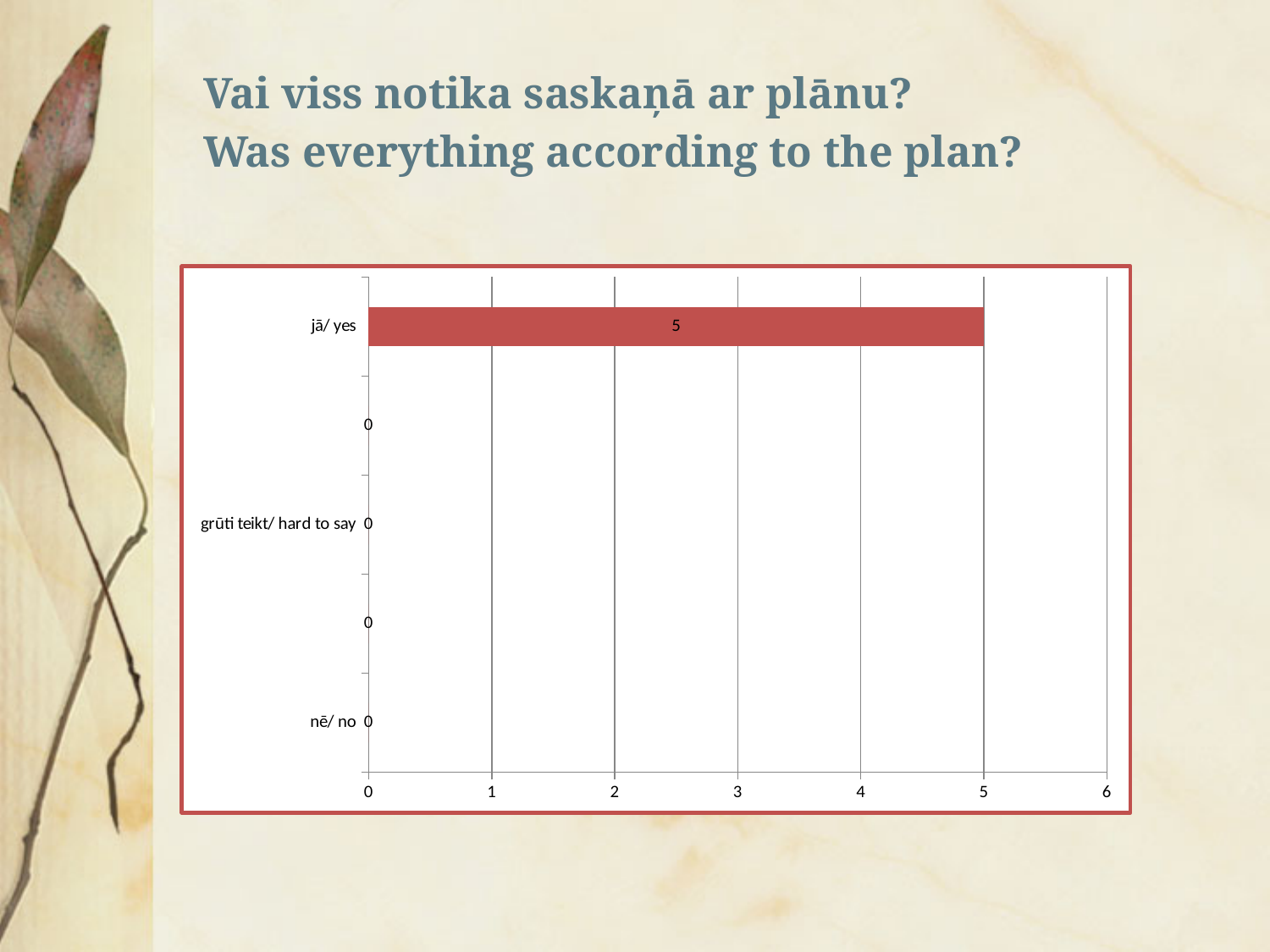
What is the highest value shown on the horizontal axis? 6 What is the difference between the values for "jā/ yes" and "nē/ no"? 5 What is the value for "jā/ yes"? 5 Which is larger, the value for "jā/ yes" or the value for "grūti teikt/ hard to say"? jā/ yes How many data labels on the chart show a value of 0? 4 What is the value for "nē/ no"? 0 What colour is the bar for "jā/ yes"? red Is the value for "jā/ yes" greater or less than 4? greater What is the value for "grūti teikt/ hard to say"? 0 Which category has the highest value? jā/ yes What kind of chart is shown on the slide? bar chart Is the value for "jā/ yes" greater or less than 6? less